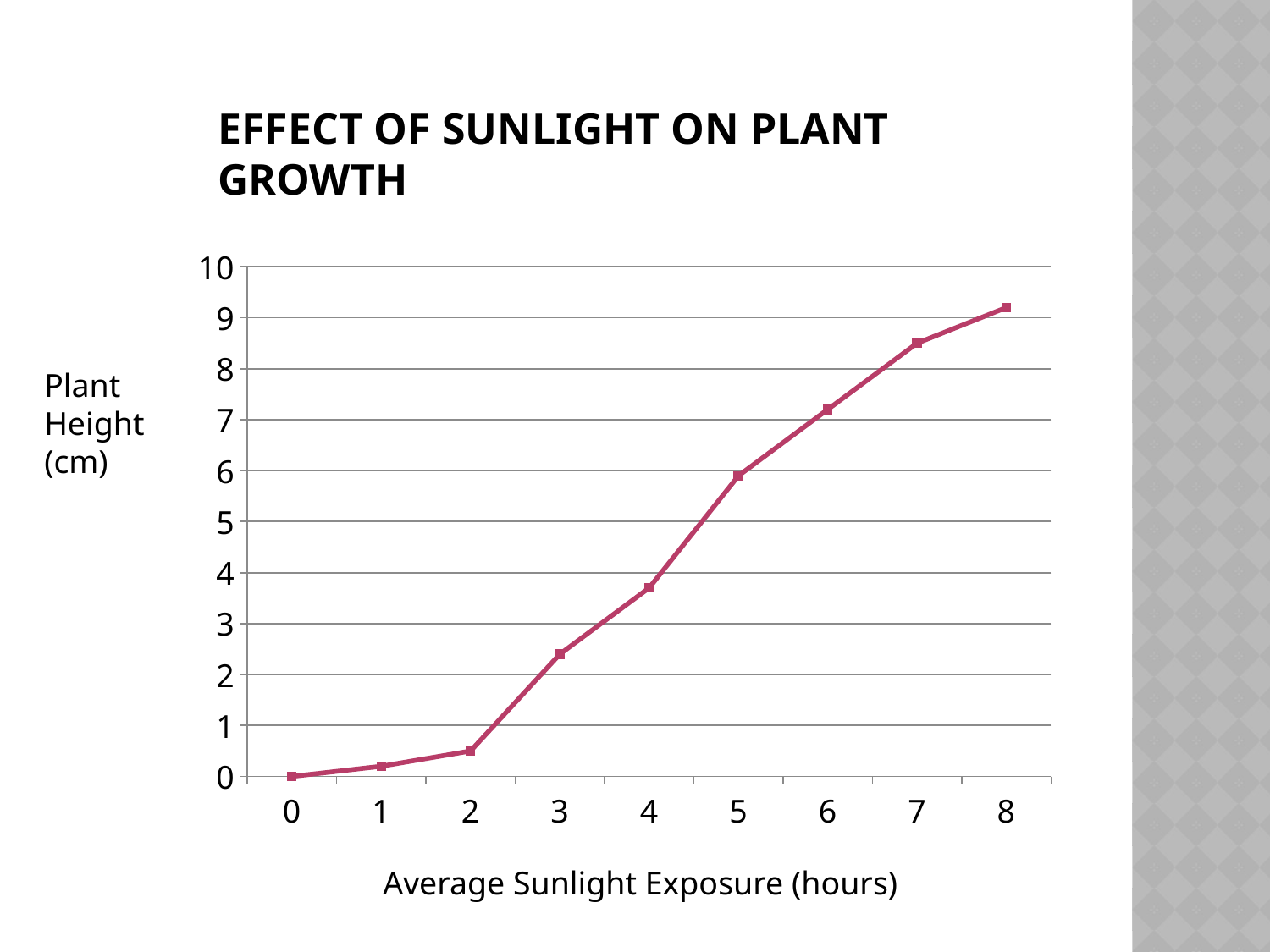
At which sunlight exposure value is the plant height highest? 8 Is the plant height at 2 hours greater or less than 1? less What kind of chart is shown on the slide? line chart Is the plant height at 8 hours greater or less than 9? greater Which has a greater plant height: 4 hours or 6 hours of sunlight exposure? 6 hours Do plant height values rise or fall as average sunlight exposure increases? rise What is the plant height at 0 hours of average sunlight exposure? 0 What is the label of the x axis? Average Sunlight Exposure (hours) Is the plant height at 5 hours greater or less than 5? greater How many data points are plotted on the line? 9 At which sunlight exposure value is the plant height lowest? 0